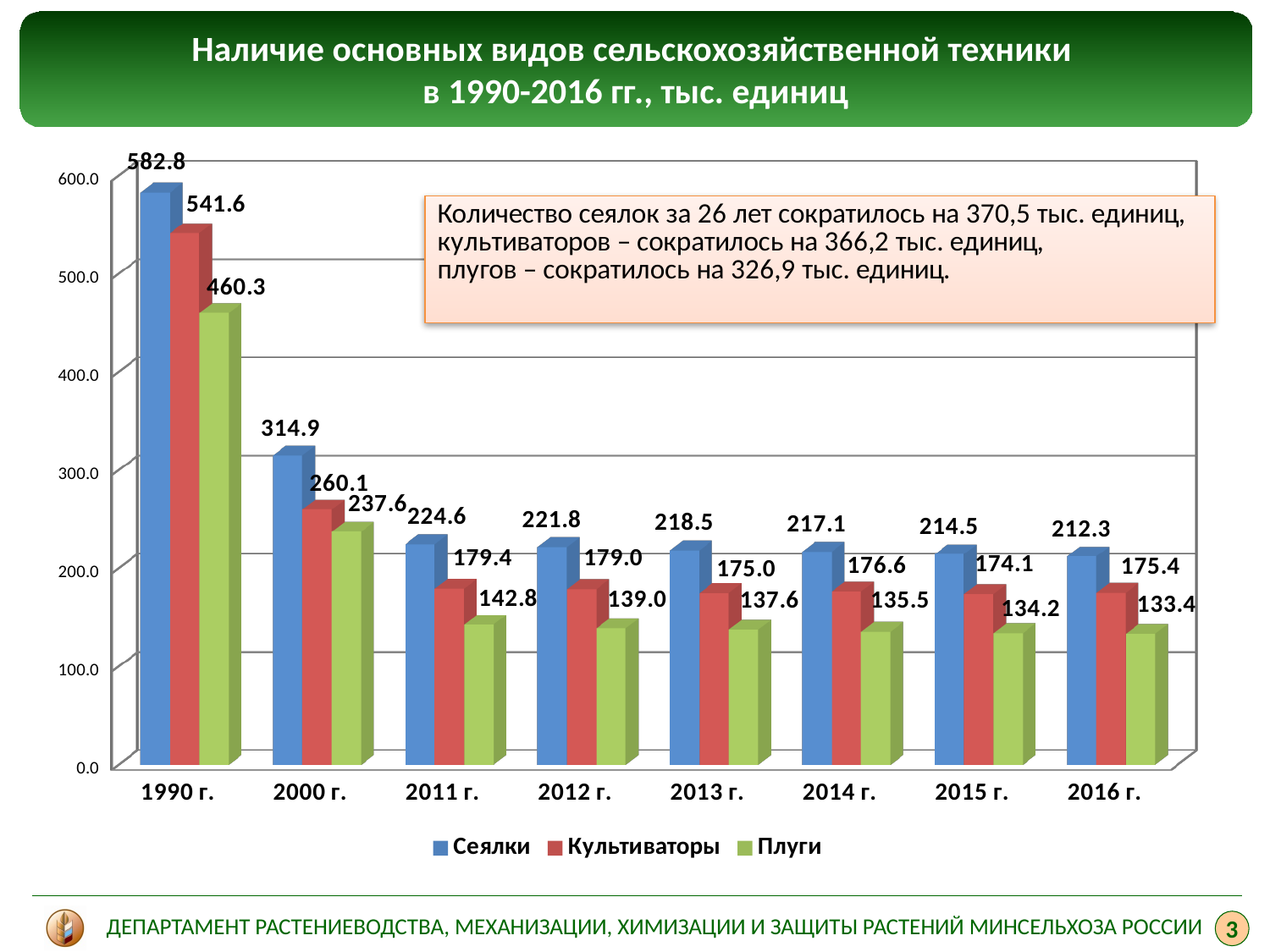
Do the values for Сеялки rise or fall from 1990 г. to 2016 г.? fall How many series does the legend list? 3 What is the difference between the Сеялки values in 1990 г. and 2016 г.? 370.5 What kind of chart is shown on the slide? bar chart How many years are shown on the x axis? 8 In which year is the value for Плуги the lowest? 2016 г. In which year is the value for Культиваторы the highest? 1990 г. What is the value for Сеялки in 1990 г.? 582.8 What is the value for Плуги in 2016 г.? 133.4 Is the value for Сеялки in 2000 г. greater or less than 300.0? greater What is the value for Культиваторы in 2013 г.? 175.0 Which is larger: Культиваторы in 2000 г. or Плуги in 2000 г.? Культиваторы in 2000 г.